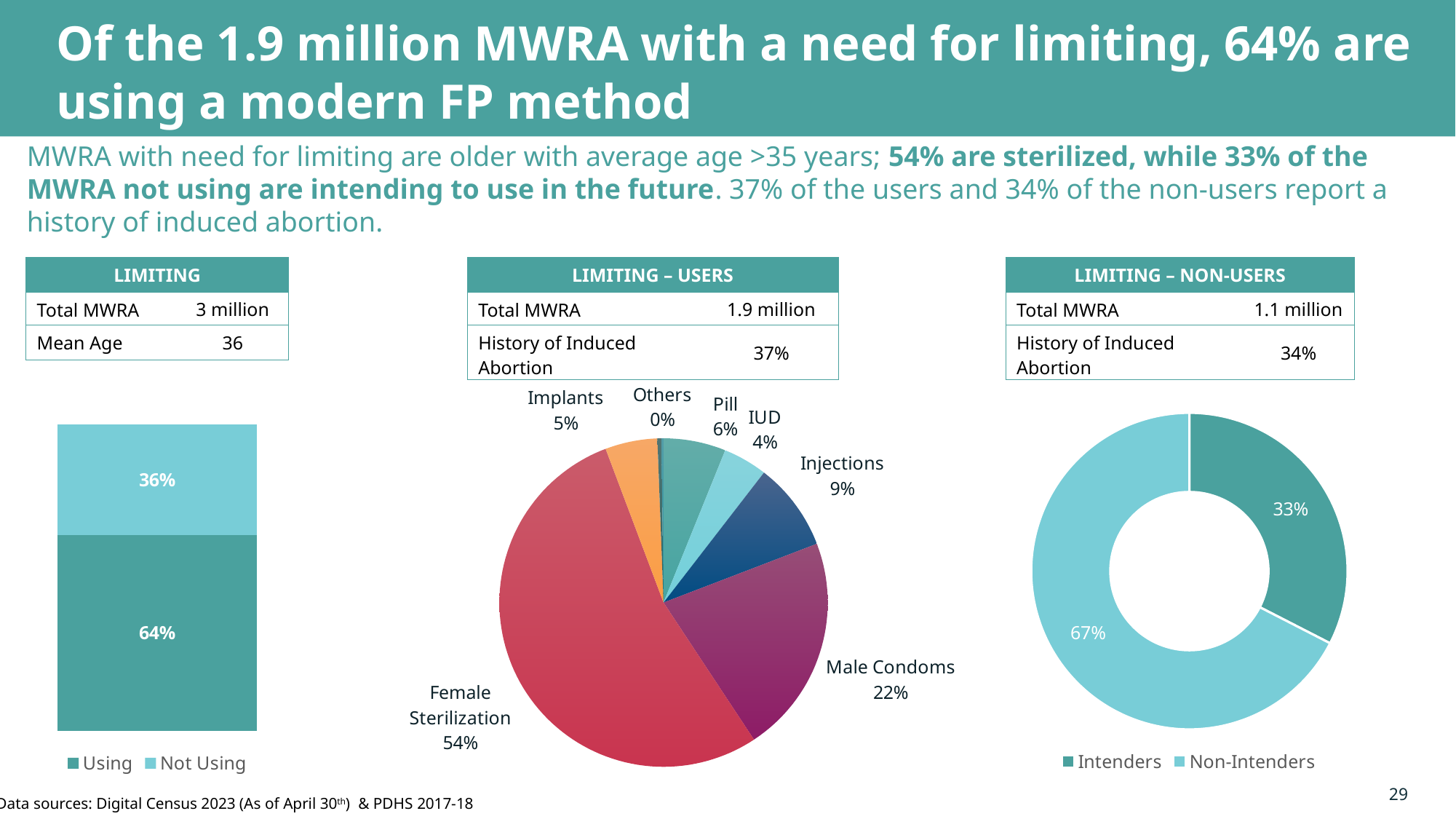
What kind of chart is shown on the right of the slide under the LIMITING – NON-USERS table? Donut chart In the pie chart in the middle of the slide, which method has the smallest share? Others In the pie chart in the middle of the slide, what is the difference between the shares for Injections and IUD? 5% In the pie chart in the middle of the slide, which method has the largest share? Female Sterilization In the stacked bar chart on the left of the slide, what percentage is labelled Using? 64% In the pie chart in the middle of the slide, what is the value for Male Condoms? 22% In the stacked bar chart on the left of the slide, what is the difference between the Using and Not Using segments? 28% In the pie chart in the middle of the slide, what share of users rely on Female Sterilization? 54% How many entries does the legend of the donut chart on the right of the slide list? 2 In the pie chart in the middle of the slide, which is larger, the share for Pill or the share for Implants? Pill In the donut chart on the right of the slide, what is the value for Non-Intenders? 67%